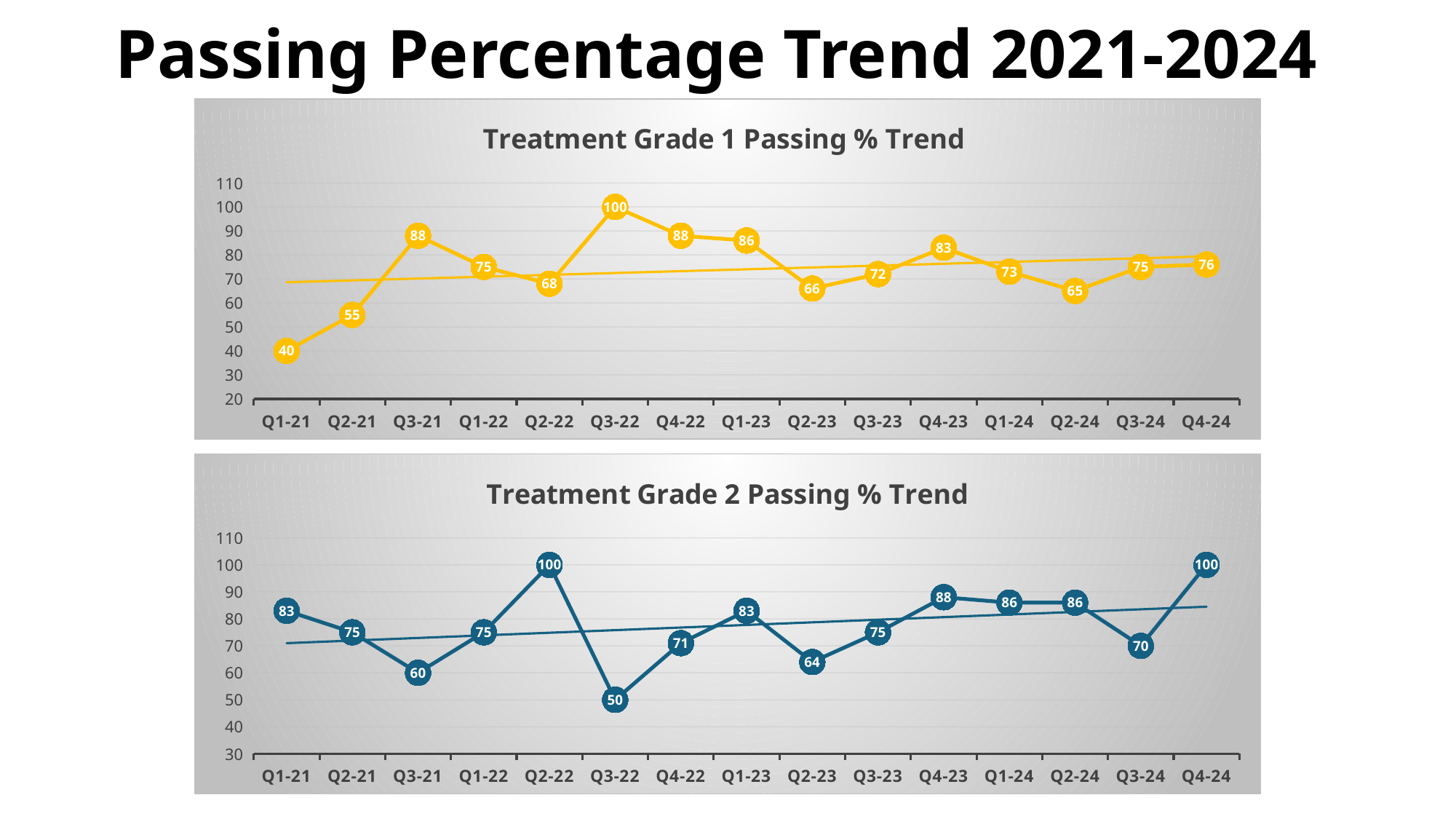
In the Treatment Grade 2 Passing % Trend chart, which is larger, the value for Q1-21 or the value for Q3-21? Q1-21 How many quarters are plotted in the Treatment Grade 1 Passing % Trend chart? 15 What kind of chart is the Treatment Grade 2 Passing % Trend chart? Line chart In the Treatment Grade 1 Passing % Trend chart, which quarter has the lowest value? Q1-21 In the Treatment Grade 1 Passing % Trend chart, what is the value for Q3-22? 100 In the Treatment Grade 2 Passing % Trend chart, what is the value for Q4-23? 88 In the Treatment Grade 2 Passing % Trend chart, what is the value for Q3-22? 50 In the Treatment Grade 1 Passing % Trend chart, what is the value for Q2-24? 65 In the Treatment Grade 2 Passing % Trend chart, what is the difference between the values for Q4-24 and Q3-24? 30 In the Treatment Grade 1 Passing % Trend chart, which quarter has the highest value? Q3-22 In the Treatment Grade 2 Passing % Trend chart, which quarter has the lowest value? Q3-22 In the Treatment Grade 1 Passing % Trend chart, what is the difference between the values for Q3-21 and Q2-22? 20